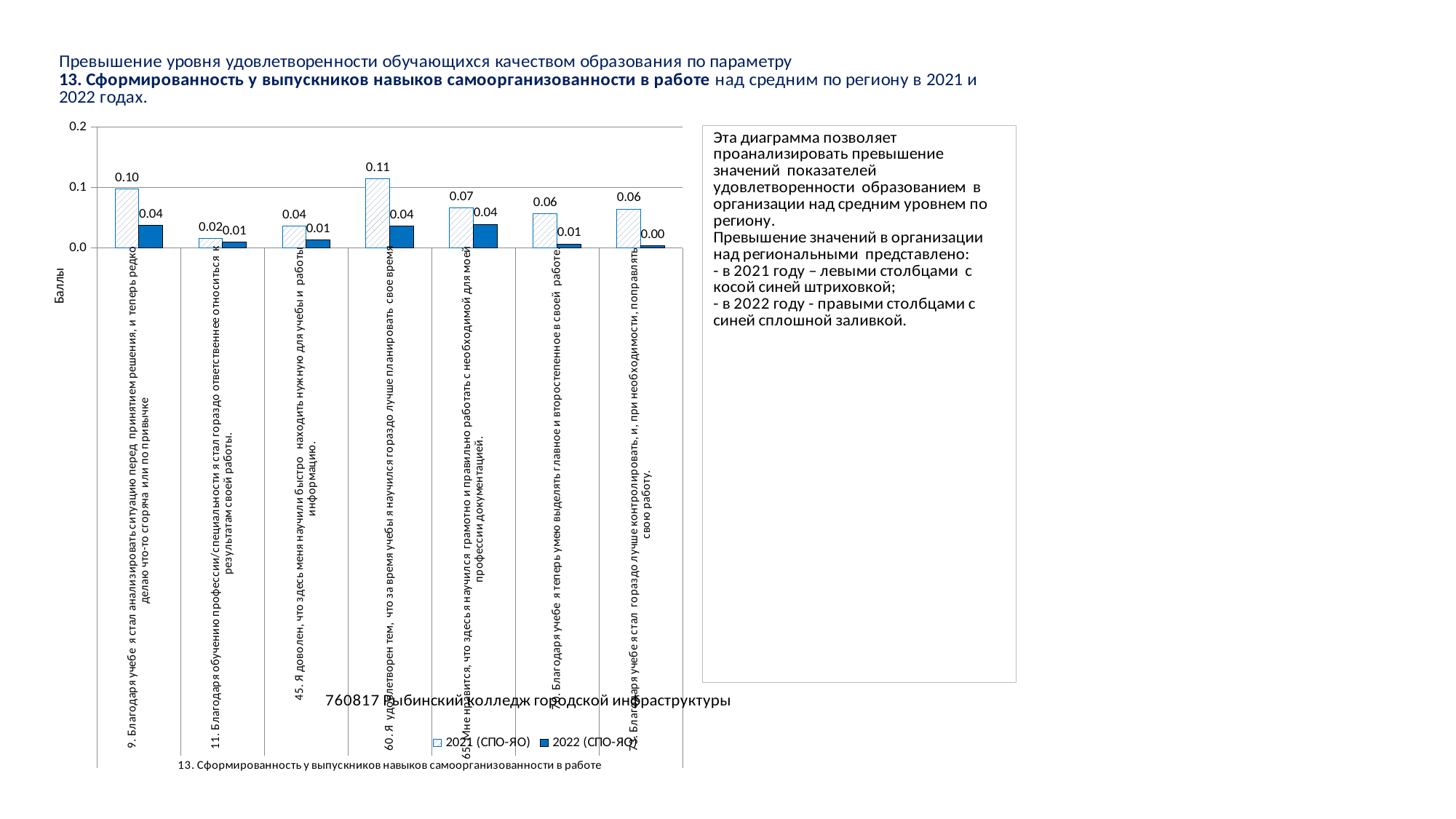
Which statement has the highest 2021 (СПО-ЯО) value? 60. Я удовлетворен тем, что за время учебы я научился гораздо лучше планировать свое время What is the difference between the 2021 values for statement 60 and statement 65? 0.04 Which statement has the lowest 2021 (СПО-ЯО) value? 11. Благодаря обучению профессии/специальности я стал гораздо ответственнее относиться к результатам своей работы What is the difference between the 2021 and 2022 values for statement 9? 0.06 What is the 2022 (СПО-ЯО) value for statement 9 ("Благодаря учебе я стал анализировать ситуацию перед принятием решения...")? 0.04 Which is larger: the 2021 value for statement 65 or the 2021 value for statement 70? Statement 65 (0.07) What type of chart is shown on the slide? Bar chart Is the 2021 value for statement 60 greater or less than 0.1? greater How many series does the legend list? 2 What is the 2021 (СПО-ЯО) value for statement 60 ("Я удовлетворен тем, что за время учебы я научился гораздо лучше планировать свое время")? 0.11 How many statements (categories) are shown on the x axis? 7